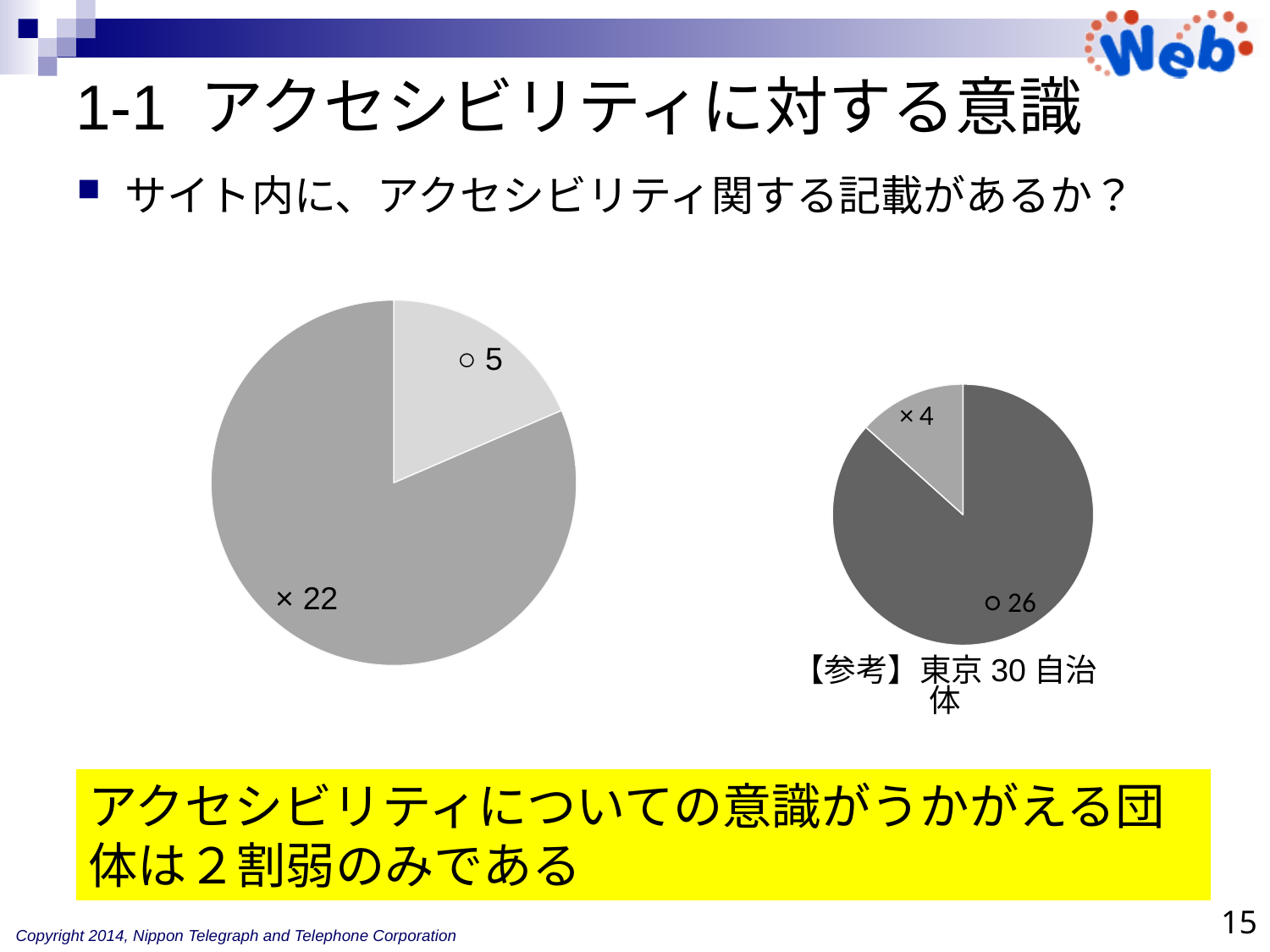
In the right pie chart (【参考】東京30自治体), which is larger, the ○ slice or the × slice? ○ In the right pie chart (【参考】東京30自治体), which slice is the smallest? × In the left pie chart, what is the value for the × slice? 22 What is the total of the two values shown in the left pie chart? 27 What kind of chart is the left chart on the slide? pie chart In the right pie chart (【参考】東京30自治体), what is the difference between the ○ value and the × value? 22 In the left pie chart, what is the value for the ○ slice? 5 In the right pie chart (【参考】東京30自治体), what is the value for the × slice? 4 In the left pie chart, which slice is the largest? × How many slices does the left pie chart have? 2 In the left pie chart, what is the difference between the × value and the ○ value? 17 In the right pie chart (【参考】東京30自治体), what is the value for the ○ slice? 26